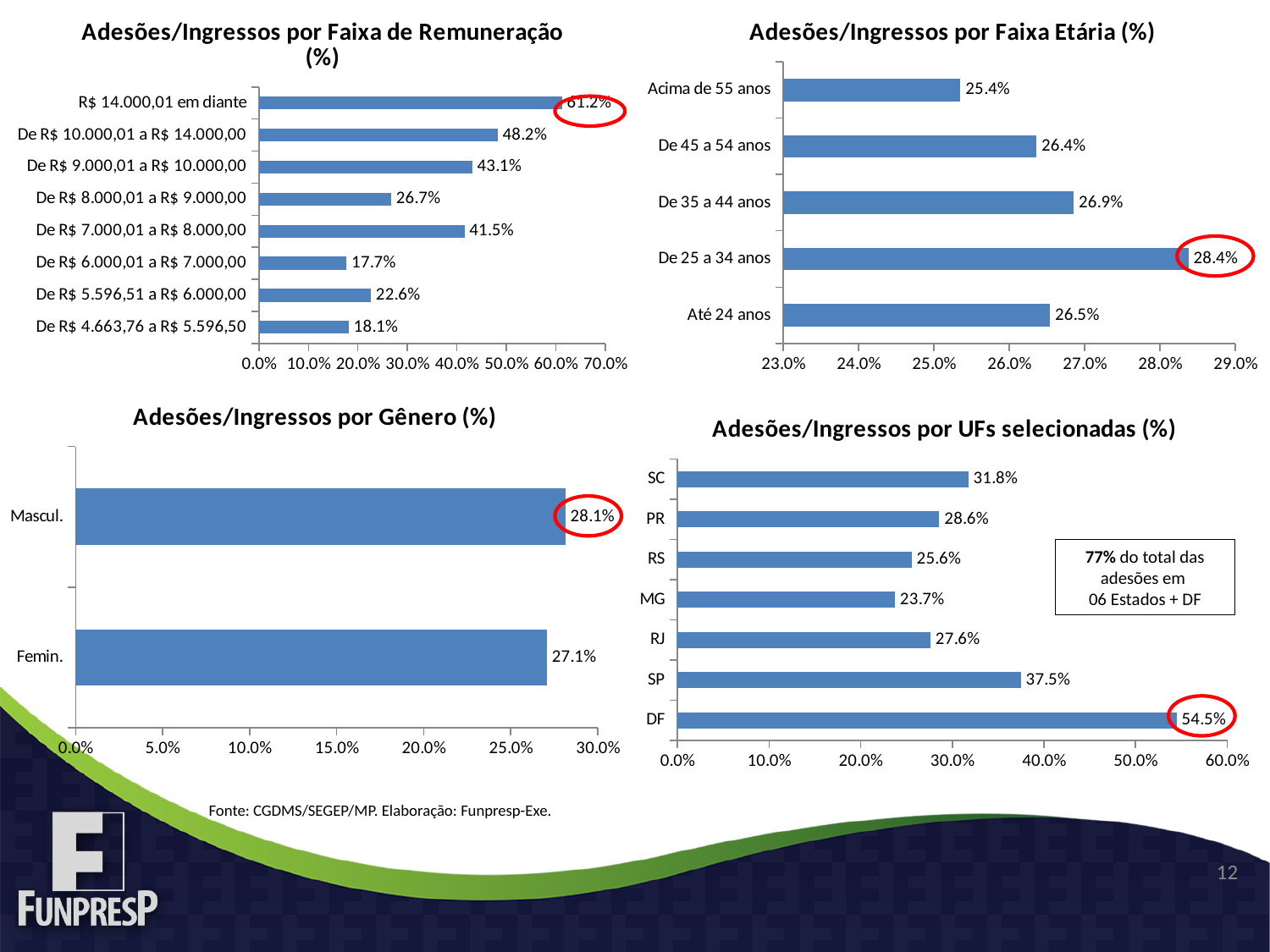
In the chart 'Adesões/Ingressos por Faixa de Remuneração (%)', which salary range has the lowest value? De R$ 6.000,01 a R$ 7.000,00 In the chart 'Adesões/Ingressos por Faixa de Remuneração (%)', what is the difference between 'De R$ 10.000,01 a R$ 14.000,00' and 'De R$ 8.000,01 a R$ 9.000,00'? 21.5% In the chart 'Adesões/Ingressos por UFs selecionadas (%)', what is the value for SP? 37.5% In the chart 'Adesões/Ingressos por Faixa Etária (%)', which age group has the lowest value? Acima de 55 anos What type of chart is 'Adesões/Ingressos por UFs selecionadas (%)'? Bar chart In the chart 'Adesões/Ingressos por Faixa de Remuneração (%)', how many salary ranges are shown? 8 In the chart 'Adesões/Ingressos por Gênero (%)', what is the value for 'Femin.'? 27.1% In the chart 'Adesões/Ingressos por UFs selecionadas (%)', which UF has the lowest value? MG In the chart 'Adesões/Ingressos por Faixa Etária (%)', what is the value for 'De 35 a 44 anos'? 26.9% In the chart 'Adesões/Ingressos por Faixa Etária (%)', which age group has the highest value? De 25 a 34 anos In the chart 'Adesões/Ingressos por Gênero (%)', what is the difference between 'Mascul.' and 'Femin.'? 1.0% In the chart 'Adesões/Ingressos por Faixa de Remuneração (%)', what is the value for 'De R$ 9.000,01 a R$ 10.000,00'? 43.1%